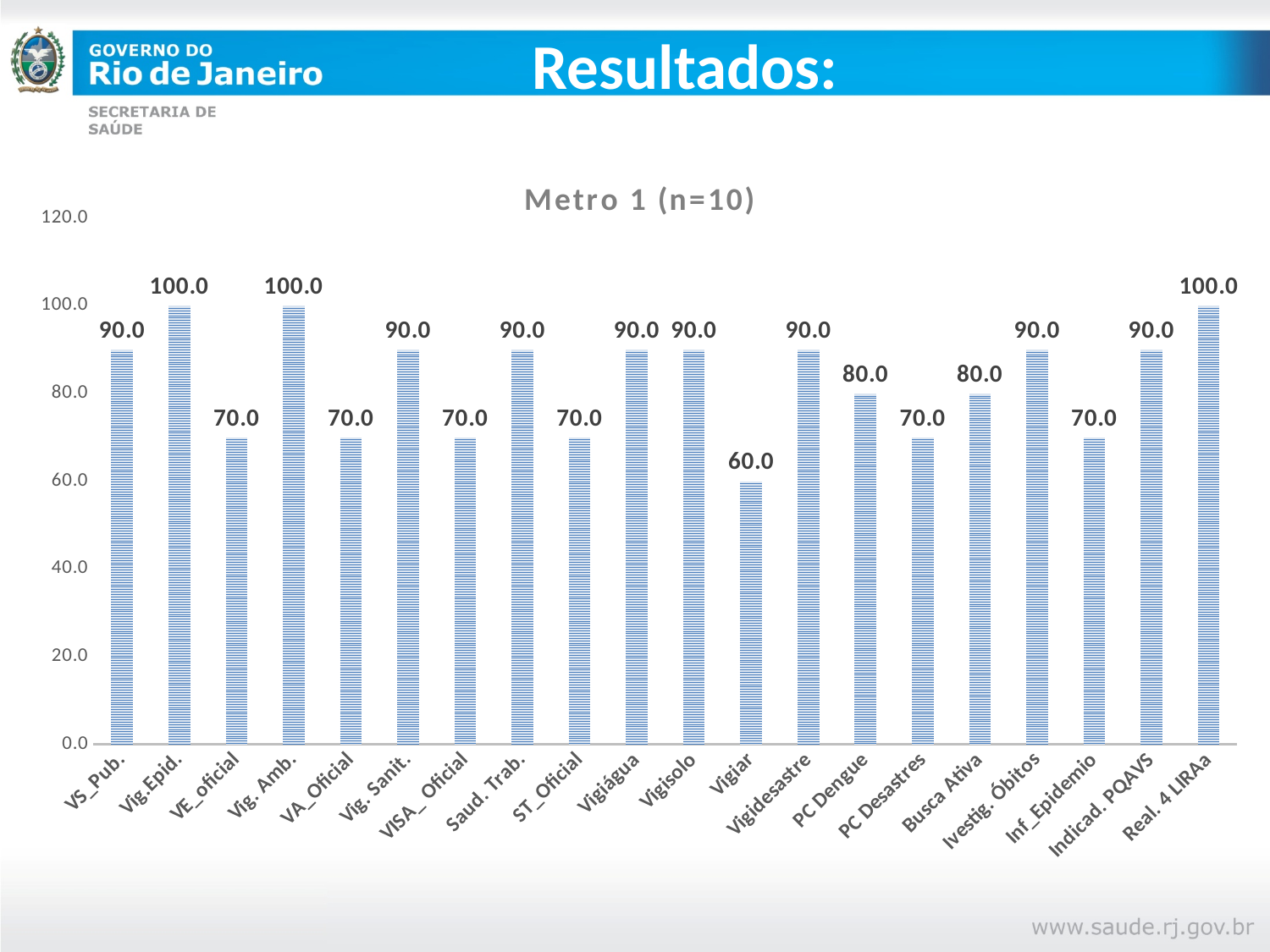
What is the value for PC Dengue? 80.0 What is the value for Inf_Epidemio? 70.0 What is the value for Vig. Amb.? 100.0 Is the value for ST_Oficial greater or less than 80.0? less Which is larger, the value for Vigidesastre or the value for PC Desastres? Vigidesastre What is the difference between the values for Vig.Epid. and VE_oficial? 30.0 How many categories are shown on the x axis? 20 What is the value for Vigiar? 60.0 What is the difference between the values for Busca Ativa and Vigiar? 20.0 What is the title of the chart? Metro 1 (n=10) What kind of chart is shown on the slide? Bar chart Which category has the lowest value? Vigiar